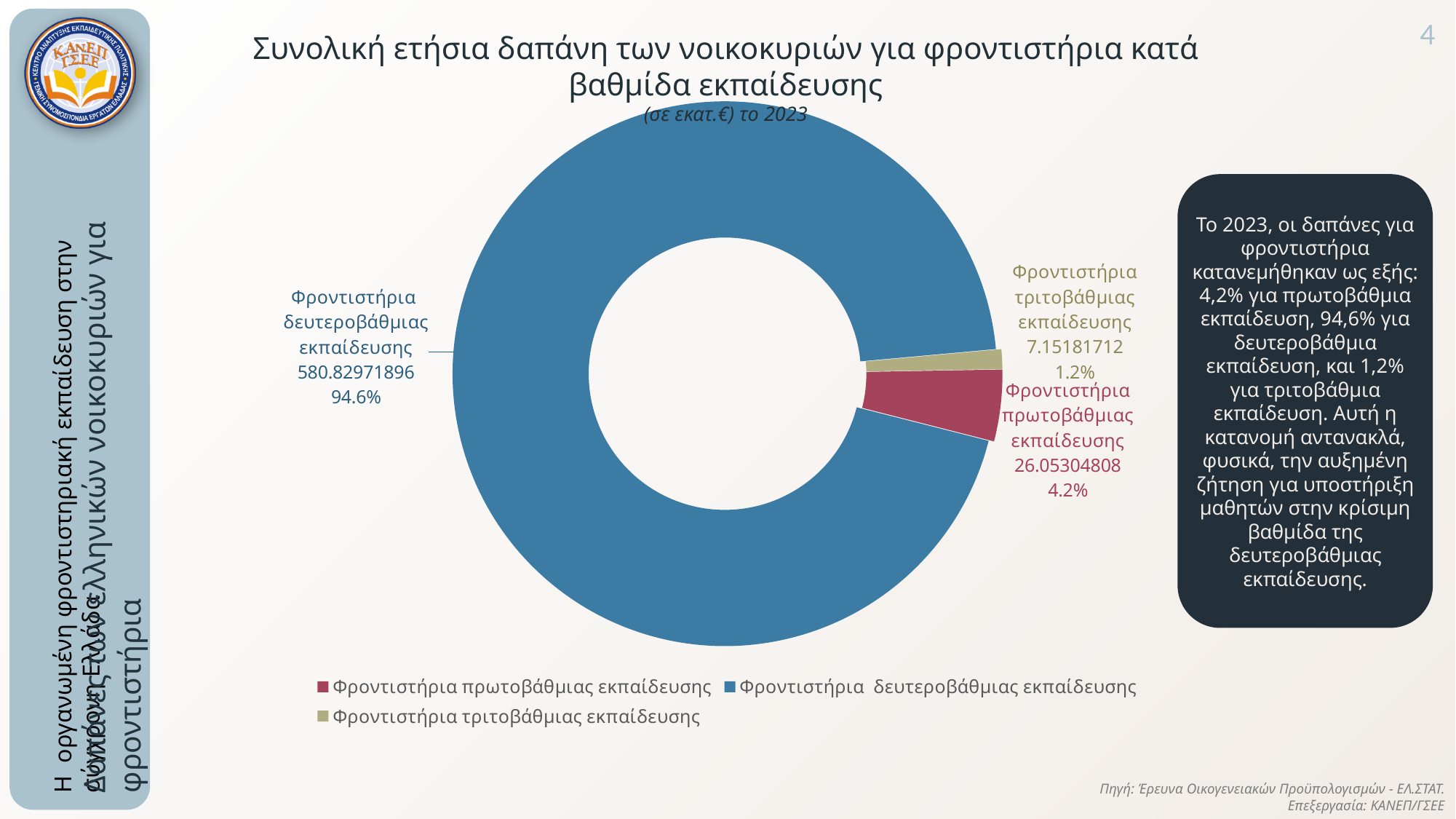
What share of the chart does Φροντιστήρια τριτοβάθμιας εκπαίδευσης represent? 1.2% What is the value for Φροντιστήρια πρωτοβάθμιας εκπαίδευσης? 26.05304808 What type of chart is shown on the slide? Doughnut (pie) chart What is the value for Φροντιστήρια δευτεροβάθμιας εκπαίδευσης? 580.82971896 How many categories does the chart show? 3 Which is larger: the value for Φροντιστήρια πρωτοβάθμιας εκπαίδευσης or Φροντιστήρια τριτοβάθμιας εκπαίδευσης? Φροντιστήρια πρωτοβάθμιας εκπαίδευσης What share of the chart does Φροντιστήρια πρωτοβάθμιας εκπαίδευσης represent? 4.2% Which category has the smallest value? Φροντιστήρια τριτοβάθμιας εκπαίδευσης What is the value for Φροντιστήρια τριτοβάθμιας εκπαίδευσης? 7.15181712 What colour is the slice for Φροντιστήρια τριτοβάθμιας εκπαίδευσης? Olive/khaki Which category has the largest value? Φροντιστήρια δευτεροβάθμιας εκπαίδευσης What share of the chart does Φροντιστήρια δευτεροβάθμιας εκπαίδευσης represent? 94.6%